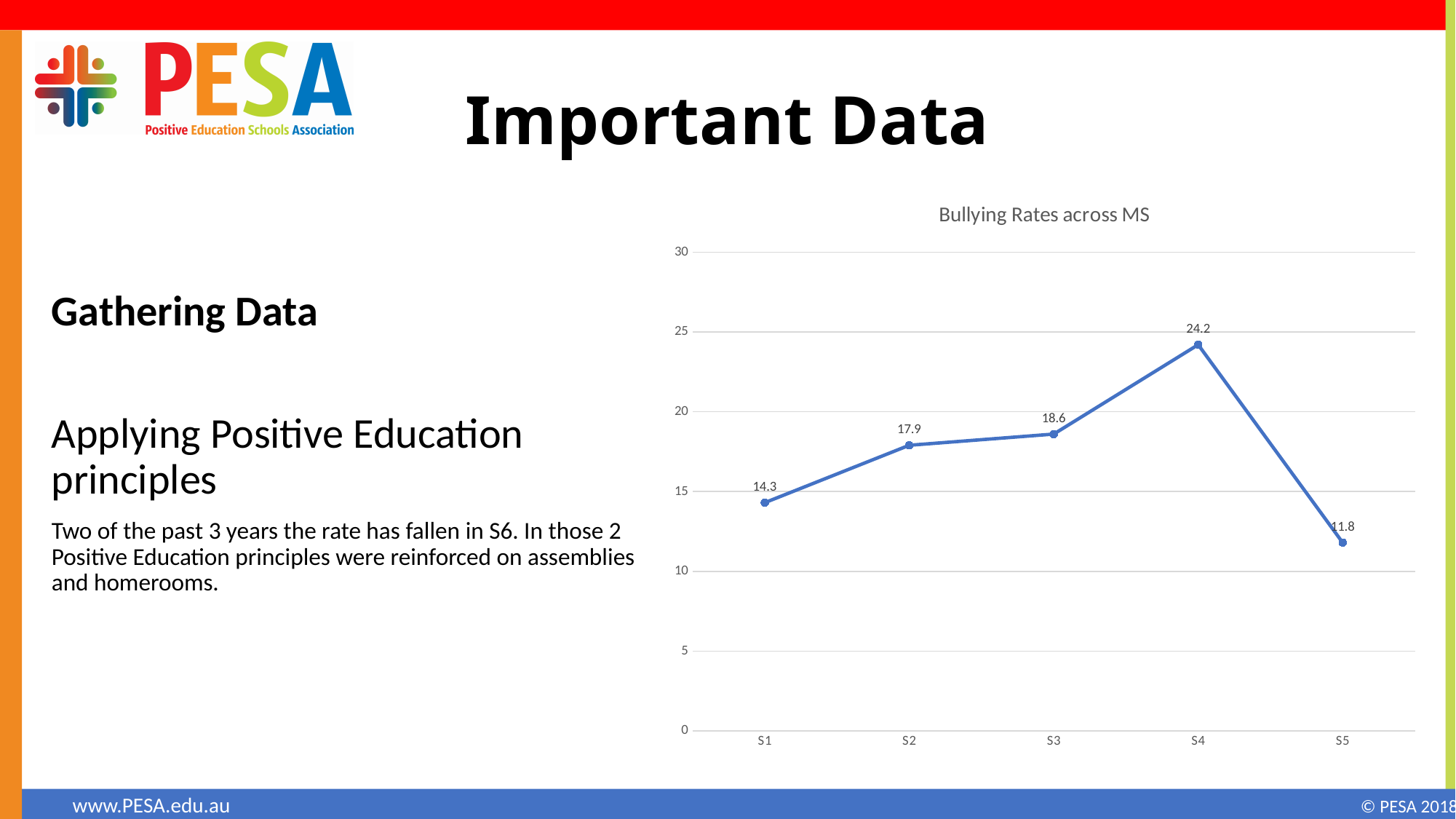
What is the difference between the bullying rates for S4 and S5? 12.4 Which category has the highest bullying rate? S4 What is the difference between the bullying rates for S2 and S1? 3.6 What is the title of the chart? Bullying Rates across MS Which has a higher bullying rate, S3 or S2? S3 What is the bullying rate for S1? 14.3 What is the bullying rate for S5? 11.8 How many categories are plotted on the x axis? 5 Is the value for S4 greater or less than 20? greater What is the bullying rate for S4? 24.2 What kind of chart is shown on the slide? Line chart Which category has the lowest bullying rate? S5